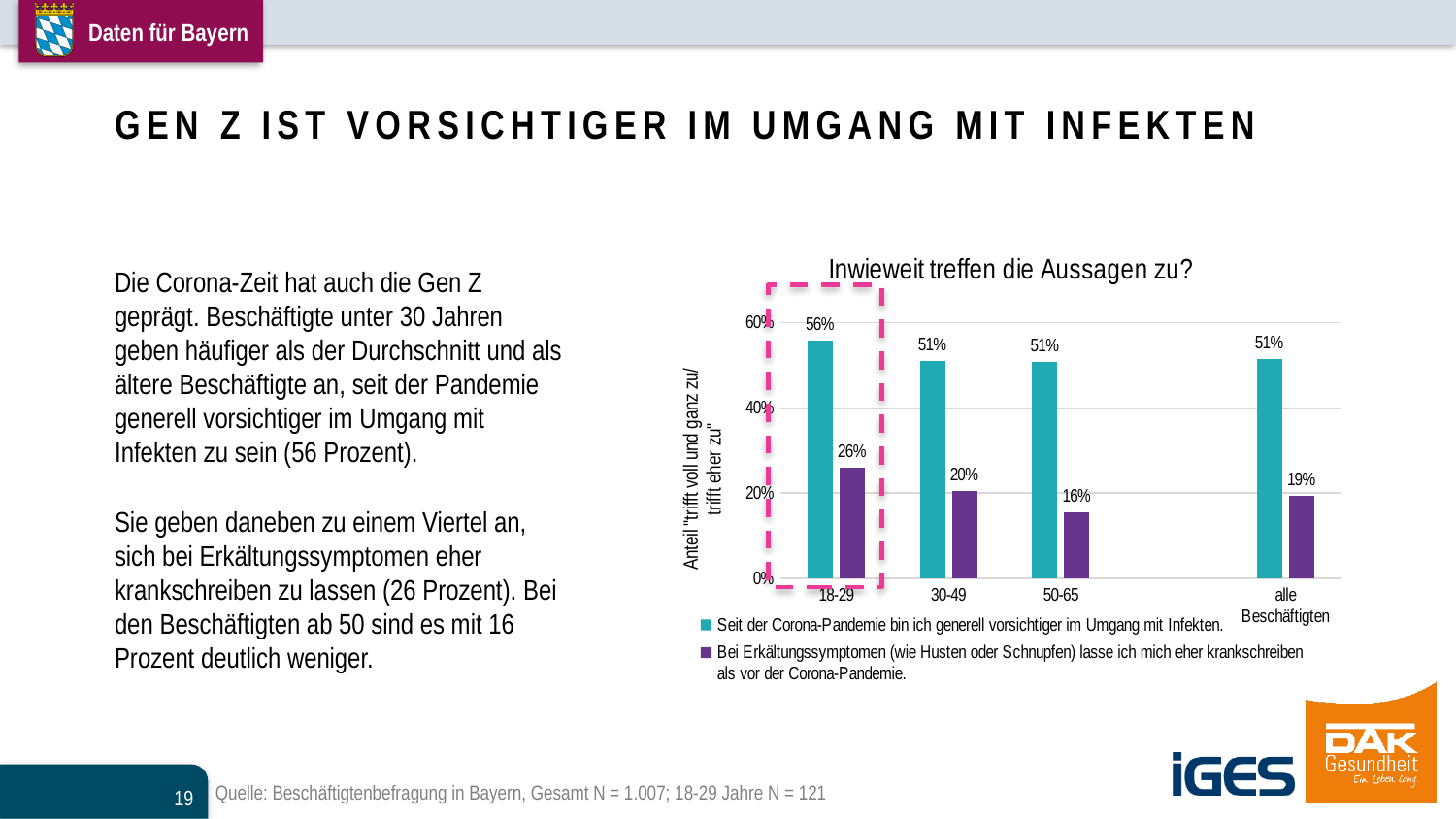
What is the difference between the 18-29 group and "alle Beschäftigten" for the statement about being more careful with infections? 5 percentage points How many age categories are shown on the x axis of the chart? 4 Which age group has the highest value for "Seit der Corona-Pandemie bin ich generell vorsichtiger im Umgang mit Infekten"? 18-29 What is the difference between the 18-29 group and the 50-65 group for the statement about taking sick leave for cold symptoms? 10 percentage points What percentage of the 50-65 age group agree with "Bei Erkältungssymptomen (wie Husten oder Schnupfen) lasse ich mich eher krankschreiben als vor der Corona-Pandemie"? 16% What is the value for "alle Beschäftigten" for the statement about being more likely to take sick leave for cold symptoms? 19% Which age group has the lowest value for the statement about being more likely to take sick leave for cold symptoms? 50-65 What is the title of the chart? Inwieweit treffen die Aussagen zu? Which is larger: the 30-49 value or the 50-65 value for the statement about taking sick leave for cold symptoms? 30-49 What is the value for the 18-29 age group for the statement "Seit der Corona-Pandemie bin ich generell vorsichtiger im Umgang mit Infekten"? 56% How many series does the chart legend list? 2 What type of chart is shown on the slide? Bar chart